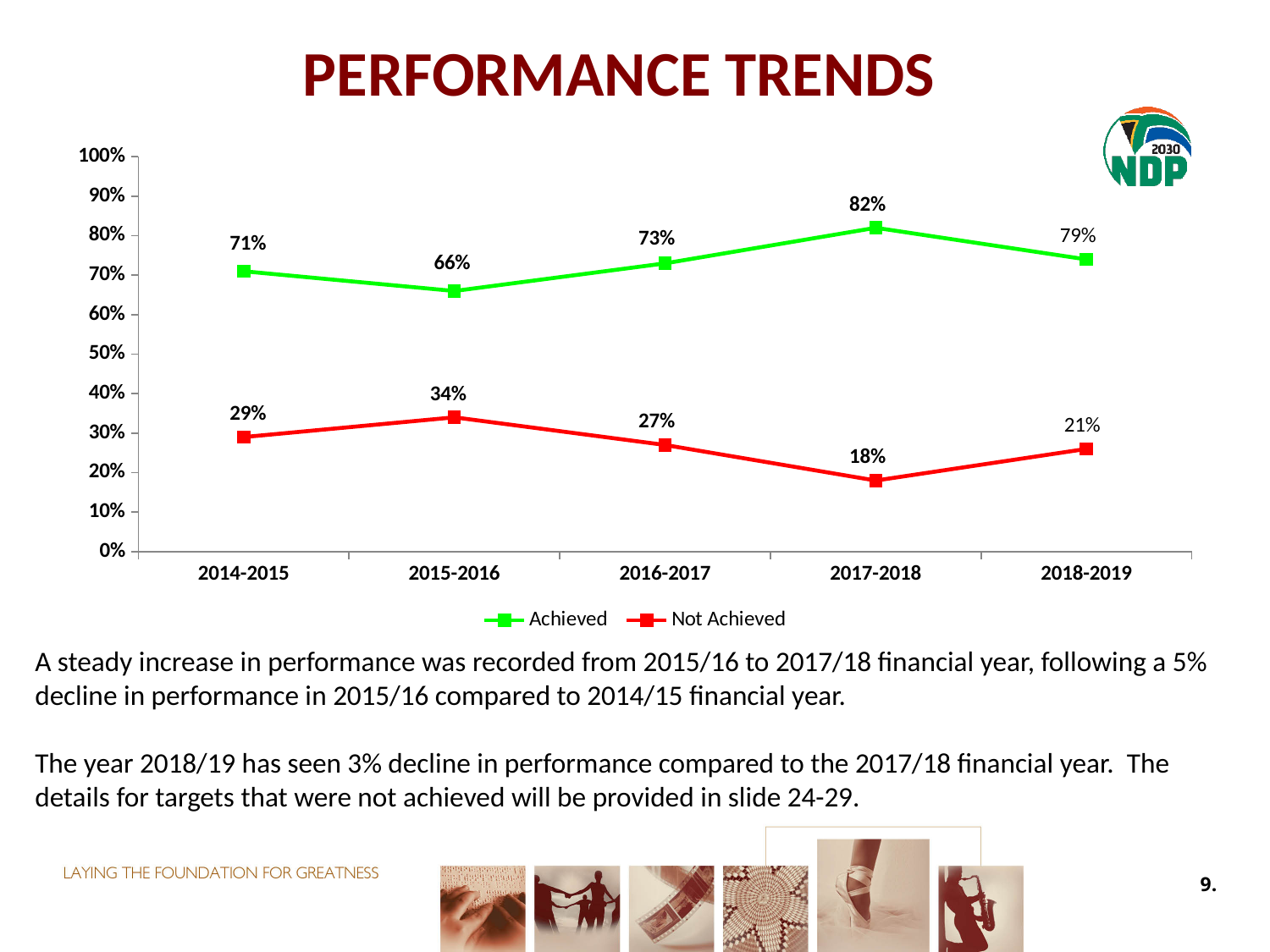
What is the difference between the Achieved values for 2017-2018 and 2015-2016? 16% What is the Achieved value for 2017-2018? 82% In which year is the Achieved value highest? 2017-2018 How many series does the legend list? 2 What is the Not Achieved value for 2015-2016? 34% What is the Achieved value for 2014-2015? 71% How many years are shown on the x axis? 5 What kind of chart is shown on the slide? Line chart What is the Not Achieved value for 2018-2019? 21% Is the Achieved value for 2015-2016 greater or less than 60%? greater In which year is the Not Achieved value lowest? 2017-2018 Which is larger, the Not Achieved value for 2014-2015 or for 2016-2017? 2014-2015